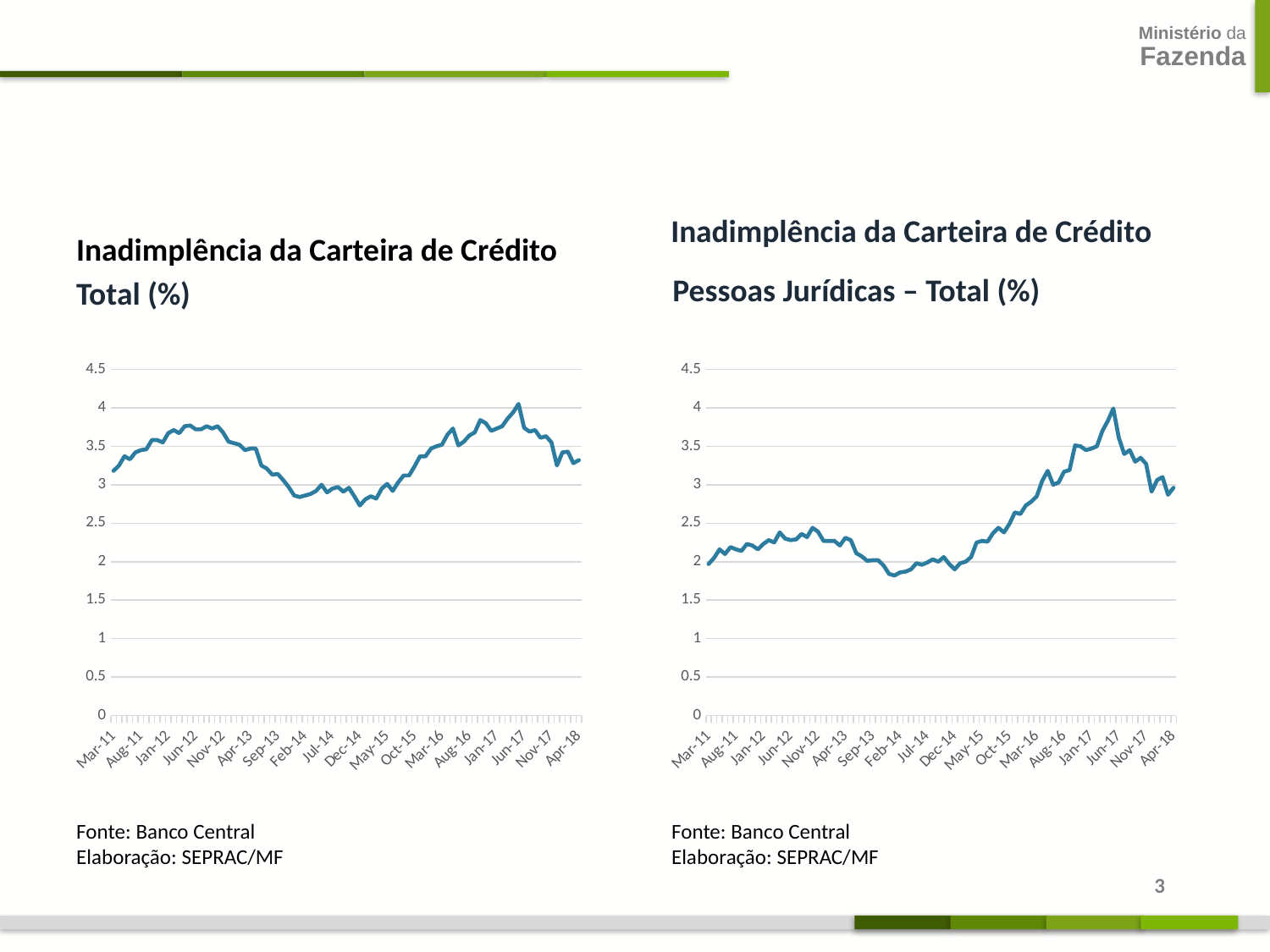
In the left chart (Total), is the value for Mar-11 greater or less than 3? greater What is the source cited below both charts? Banco Central In the left chart (Total), does the line rise or fall between Jun-12 and Feb-14? fall What type of chart is the right chart, 'Inadimplência da Carteira de Crédito Pessoas Jurídicas – Total (%)'? line chart What type of chart is the left chart, 'Inadimplência da Carteira de Crédito Total (%)'? line chart In the right chart (Pessoas Jurídicas), does the line rise or fall between Feb-14 and Jun-17? rise In the left chart (Total), is the value for Feb-14 greater or less than 3? less In the left chart (Total), is the value for Jun-17 greater or less than 3.5? greater In the right chart (Pessoas Jurídicas), which is larger, the value for Jun-17 or the value for Mar-11? Jun-17